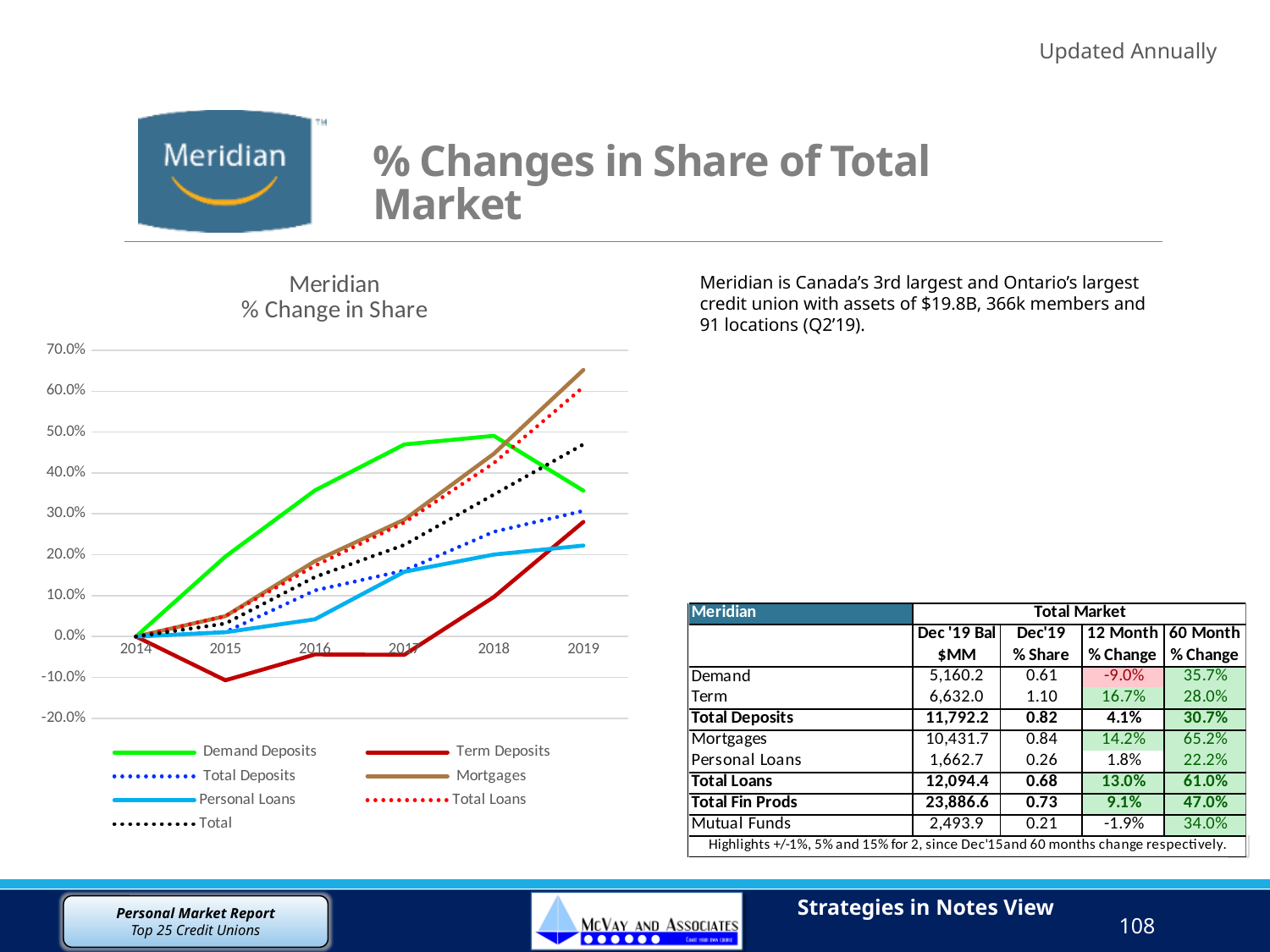
Is the value for Mortgages in 2019 greater or less than 60.0%? greater Which series has the lowest value in 2015? Term Deposits Is the value for Term Deposits in 2015 greater or less than 0.0%? less Which series has the highest value in 2019? Mortgages In 2017, which is larger: Demand Deposits or Term Deposits? Demand Deposits How many years are plotted along the x axis of the chart? 6 Does the Mortgages series rise or fall from 2014 to 2019? rise What is the title of the chart? Meridian % Change in Share What kind of chart is shown on the slide? line chart Which series has the highest value in 2016? Demand Deposits How many series does the legend of the chart list? 7 Is the value for Demand Deposits in 2018 greater or less than 40.0%? greater